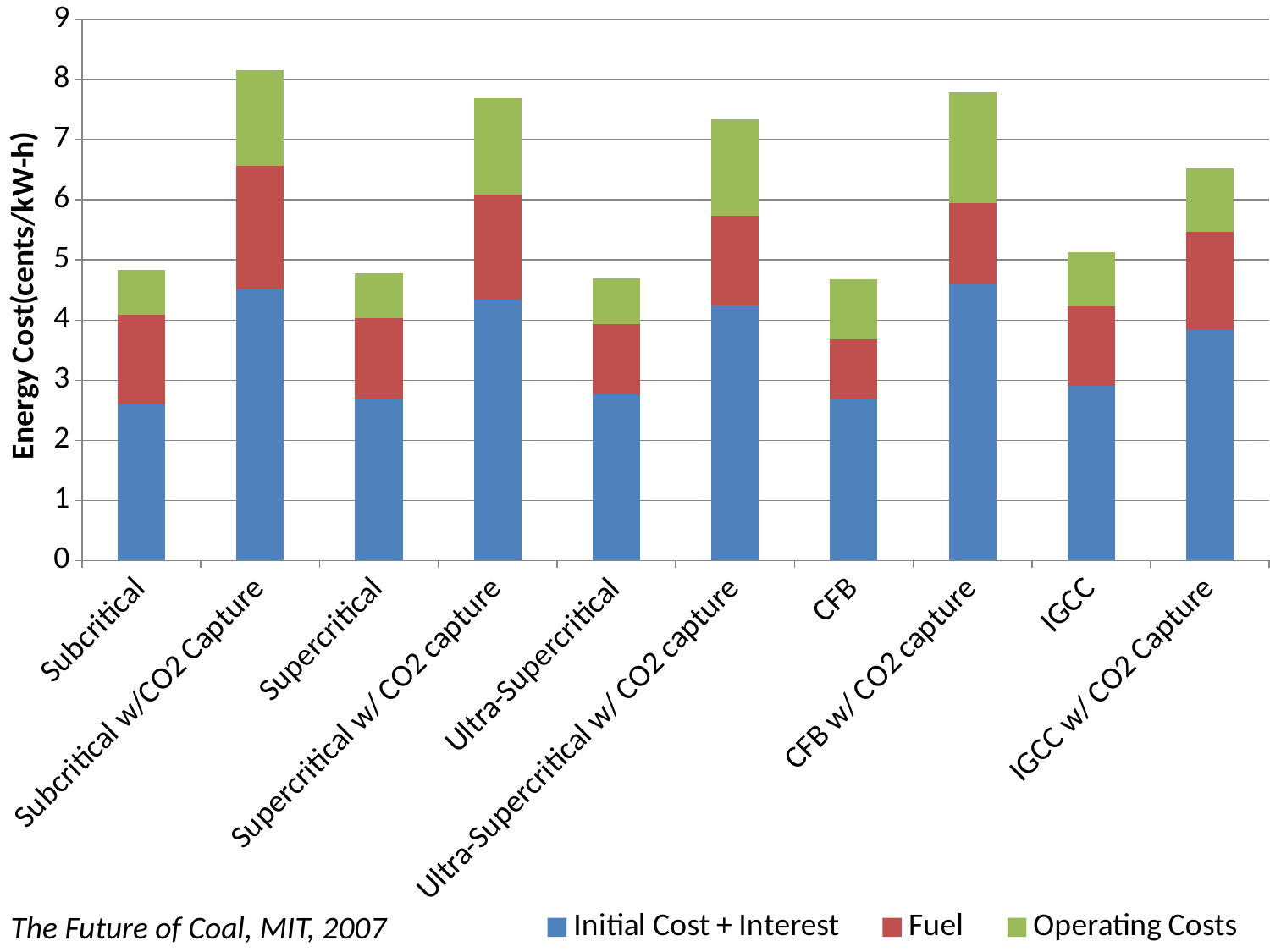
Is the total energy cost for Supercritical w/ CO2 capture greater or less than 7 cents/kW-h? greater What is the label on the y axis? Energy Cost(cents/kW-h) What kind of chart is shown on the slide? Stacked bar chart Which series is shown in green in the legend? Operating Costs Is the total energy cost for IGCC w/ CO2 Capture greater or less than 6 cents/kW-h? greater Which has a higher total energy cost, Subcritical w/CO2 Capture or Supercritical w/ CO2 capture? Subcritical w/CO2 Capture How many plant types (categories) are shown on the x axis? 10 Is the total energy cost for CFB greater or less than 5 cents/kW-h? less Which has a higher total energy cost, IGCC or IGCC w/ CO2 Capture? IGCC w/ CO2 Capture Which plant type has the highest total energy cost? Subcritical w/CO2 Capture How many series does the legend list? 3